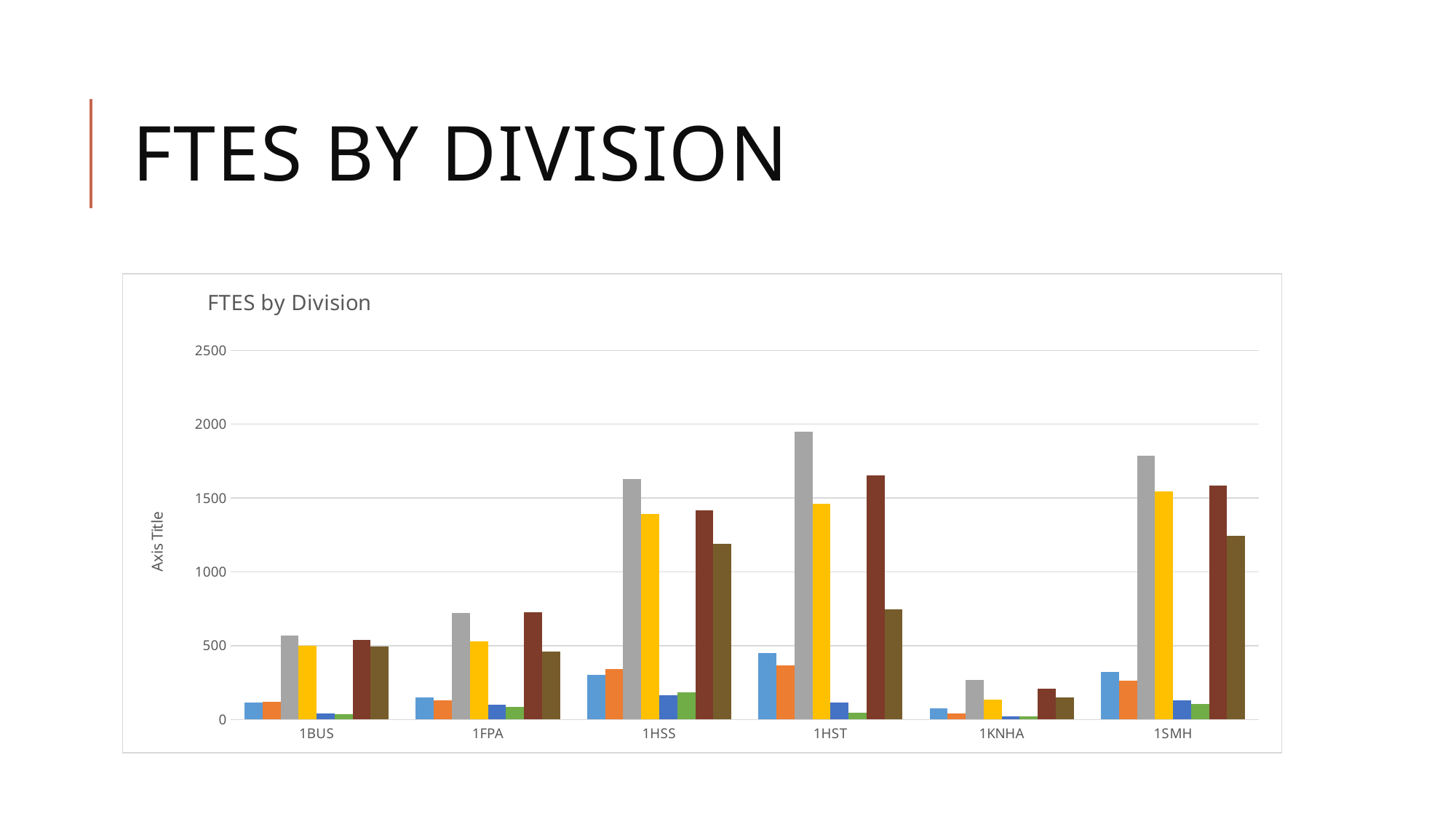
Which is larger, the gray bar for 1HSS or the gray bar for 1SMH? 1SMH Is the gray bar for 1HST greater or less than 1500? greater Which division has the lowest bars overall? 1KNHA Is the dark red bar for 1HST greater or less than 1500? greater What is the label on the vertical axis? Axis Title How many divisions (categories) are shown on the x axis? 6 Is the olive bar for 1HST greater or less than 1000? less Which division has the tallest gray bar? 1HST What is the title of the chart? FTES by Division What kind of chart is shown on the slide? bar chart